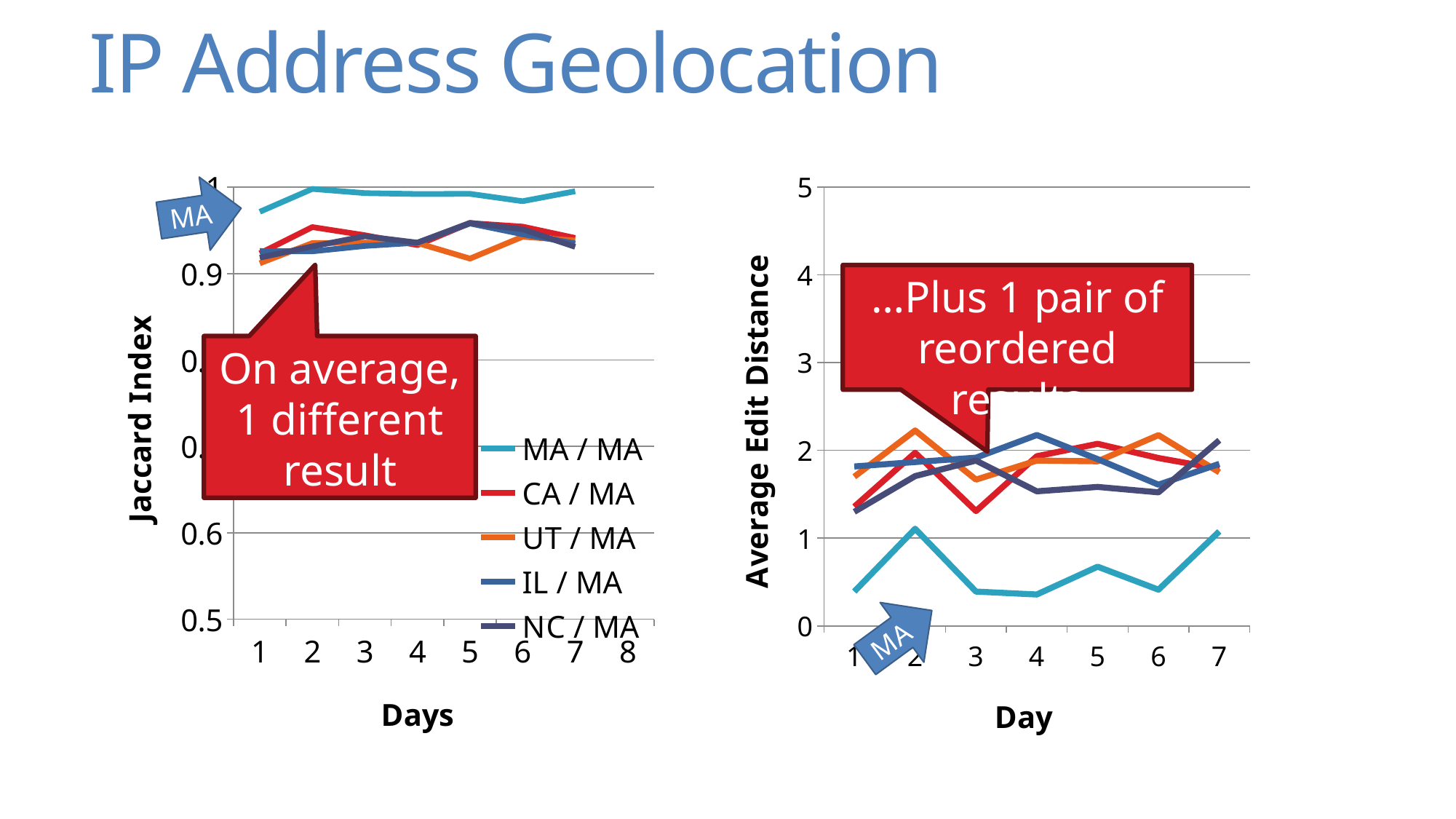
In the right chart (Average Edit Distance), how many days are shown on the x axis? 7 What type of chart is the left chart (Jaccard Index)? line chart What is the x-axis title of the left chart? Days In the left chart (Jaccard Index), does the MA / MA line rise or fall from day 1 to day 2? rise In the left chart (Jaccard Index), is the value for MA / MA on day 1 greater or less than 0.9? greater In the left chart (Jaccard Index), which series has the highest values across the days? MA / MA In the left chart (Jaccard Index), how many series does the legend list? 5 In the right chart (Average Edit Distance), does the teal line rise or fall from day 2 to day 3? fall In the right chart (Average Edit Distance), is the value of the orange line on day 2 greater or less than 2? greater What type of chart is the right chart (Average Edit Distance)? line chart In the left chart (Jaccard Index), which is larger on day 2: MA / MA or CA / MA? MA / MA In the right chart (Average Edit Distance), is the value of the lowest (teal) line on day 4 greater or less than 1? less